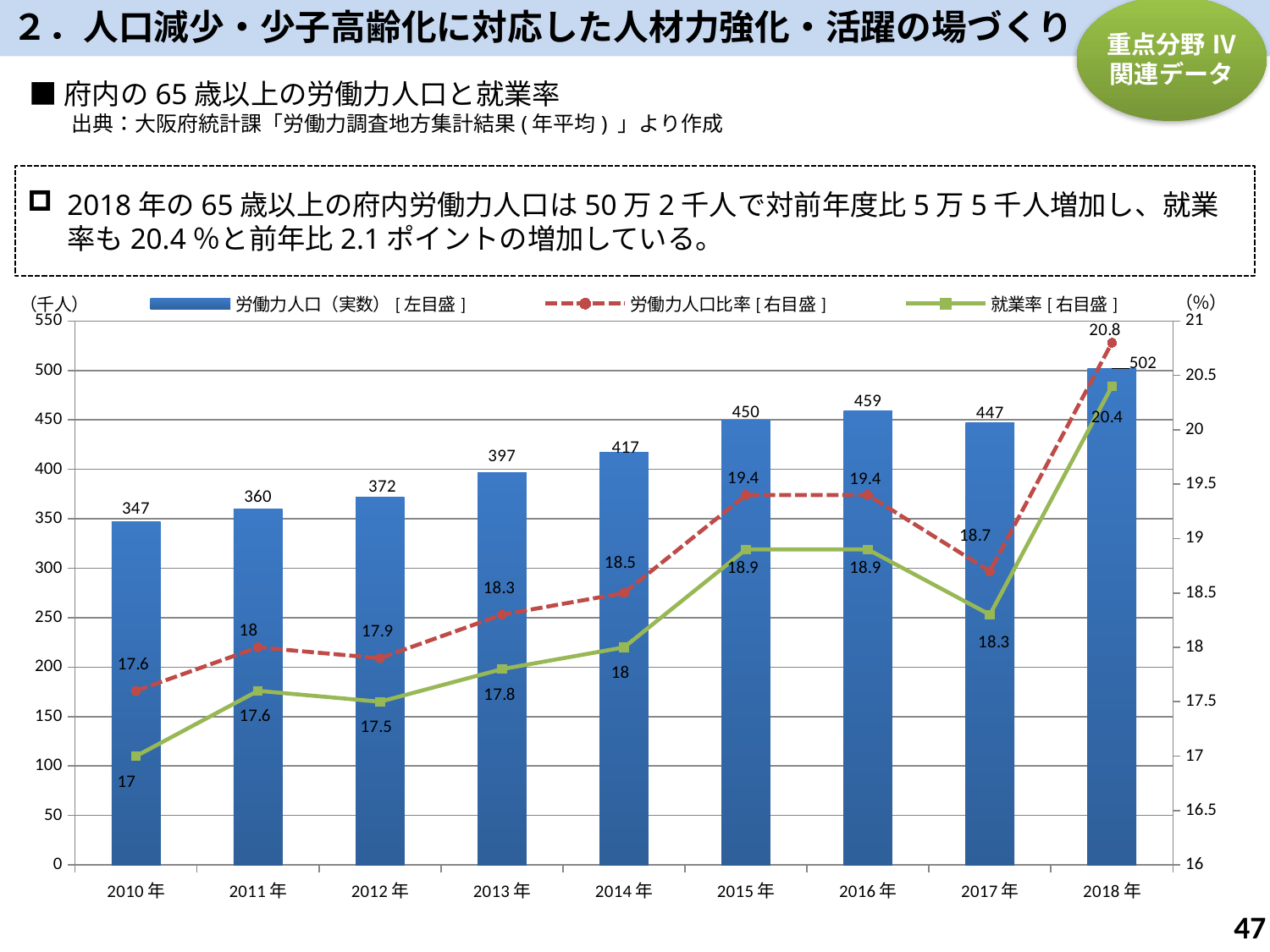
What is the difference between the 労働力人口（実数） values for 2018年 and 2017年? 55 How many years are shown on the x axis? 9 Which year has the highest 就業率 value? 2018年 What is the value of 労働力人口（実数） for 2018年? 502 What kind of chart is this? Combined bar and line chart Does the 労働力人口（実数） bar value rise or fall from 2010年 to 2014年? Rise What is the 労働力人口比率 value for 2014年? 18.5 Which year has the lowest 労働力人口（実数） bar? 2010年 How many series does the legend list? 3 What is the unit shown on the left axis? （千人） Which is larger, the 労働力人口（実数） value for 2016年 or for 2017年? 2016年 What is the 就業率 value for 2017年? 18.3